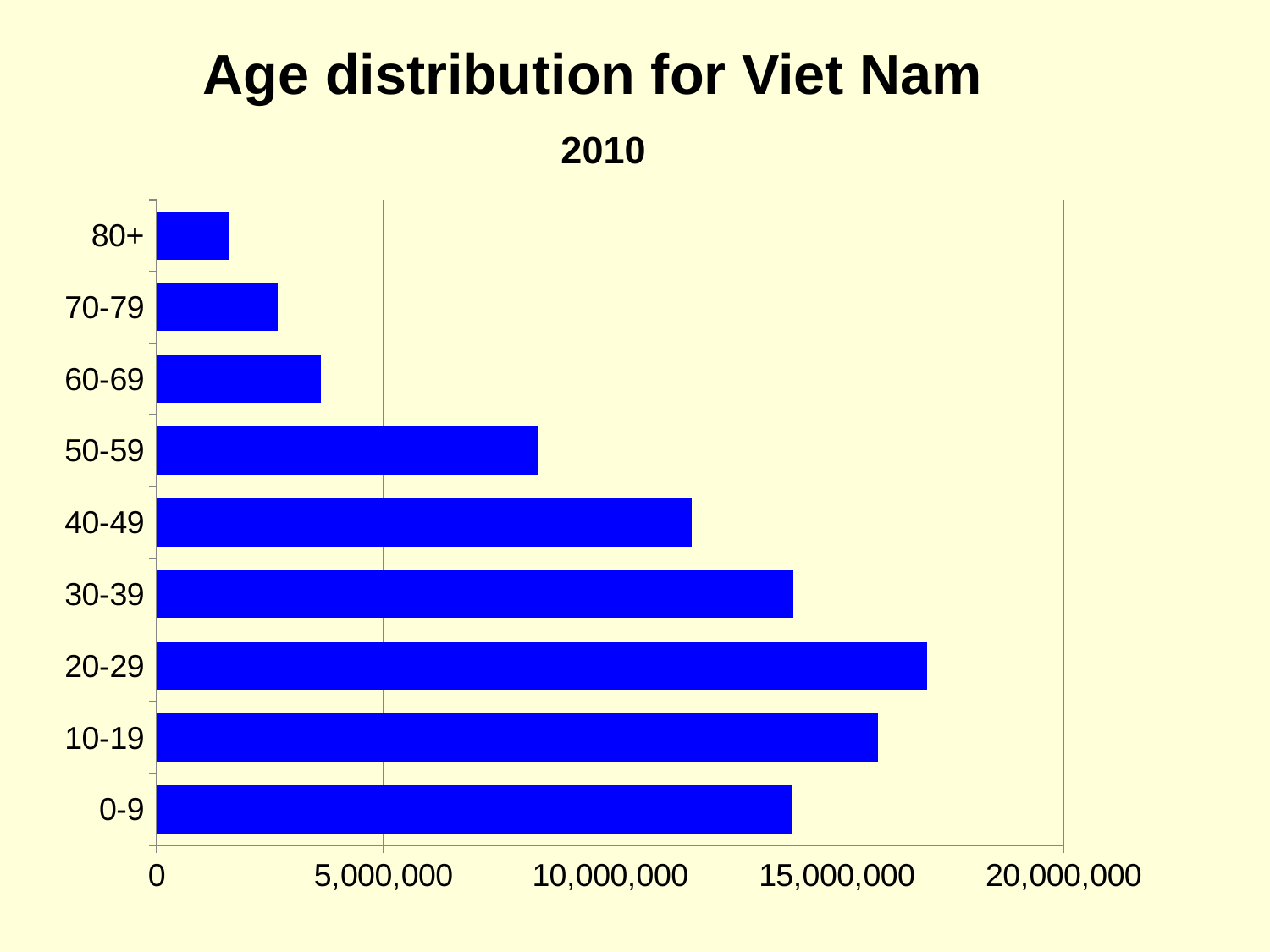
How many age groups are plotted in the chart? 9 Which age group has the highest value? 20-29 Which is larger, the value for 20-29 or the value for 10-19? 20-29 Which age group has the lowest value? 80+ What is the title of the chart? Age distribution for Viet Nam What kind of chart is shown on the slide? Bar chart Is the value for 60-69 greater or less than 5,000,000? less Is the value for 40-49 greater or less than 10,000,000? greater Is the value for 30-39 greater or less than 15,000,000? less Which is larger, the value for 50-59 or the value for 60-69? 50-59 What year does the chart show data for? 2010